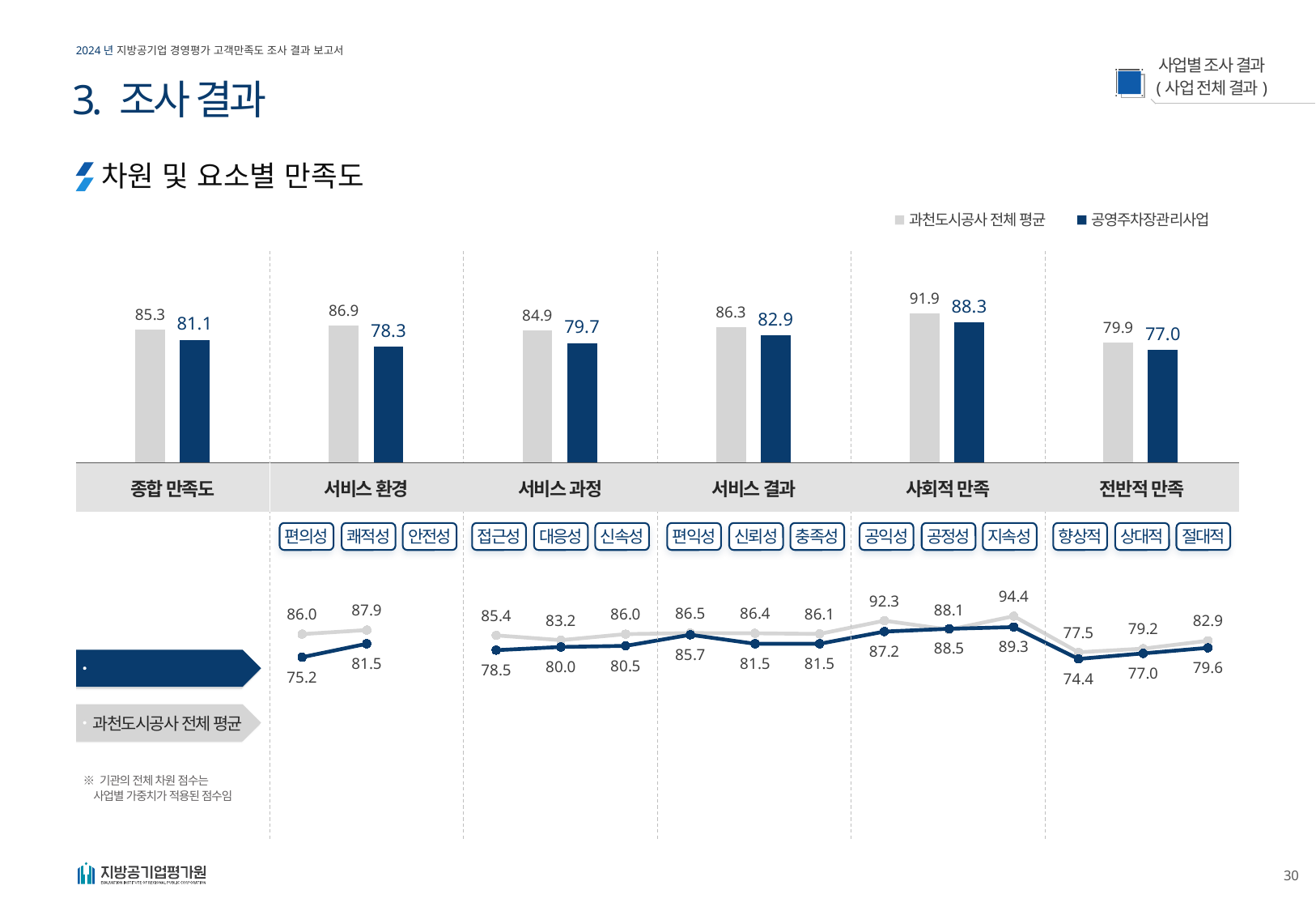
In the top bar chart, what is the 과천도시공사 전체 평균 value for 사회적 만족? 91.9 In the bottom line chart, what is the 과천도시공사 전체 평균 value for 지속성? 94.4 In the bottom line chart, which element has the lowest dark blue line value? 향상적 In the top bar chart, which category has the lowest 과천도시공사 전체 평균 value? 전반적 만족 In the bottom line chart, what is the dark blue line's value for 편의성? 75.2 In the top bar chart, which category has the highest 공영주차장관리사업 value? 사회적 만족 In the bottom line chart, which is larger for 공정성: the 과천도시공사 전체 평균 value or the dark blue line's value? the dark blue line's value (88.5) How many series does the legend of the top bar chart list? 2 In the top bar chart, what is the difference between the 과천도시공사 전체 평균 and 공영주차장관리사업 values for 서비스 환경? 8.6 What type of chart is the top chart on the slide? bar chart In the top bar chart, how many categories are shown on the x axis? 6 In the top bar chart, what is the 공영주차장관리사업 value for 종합 만족도? 81.1